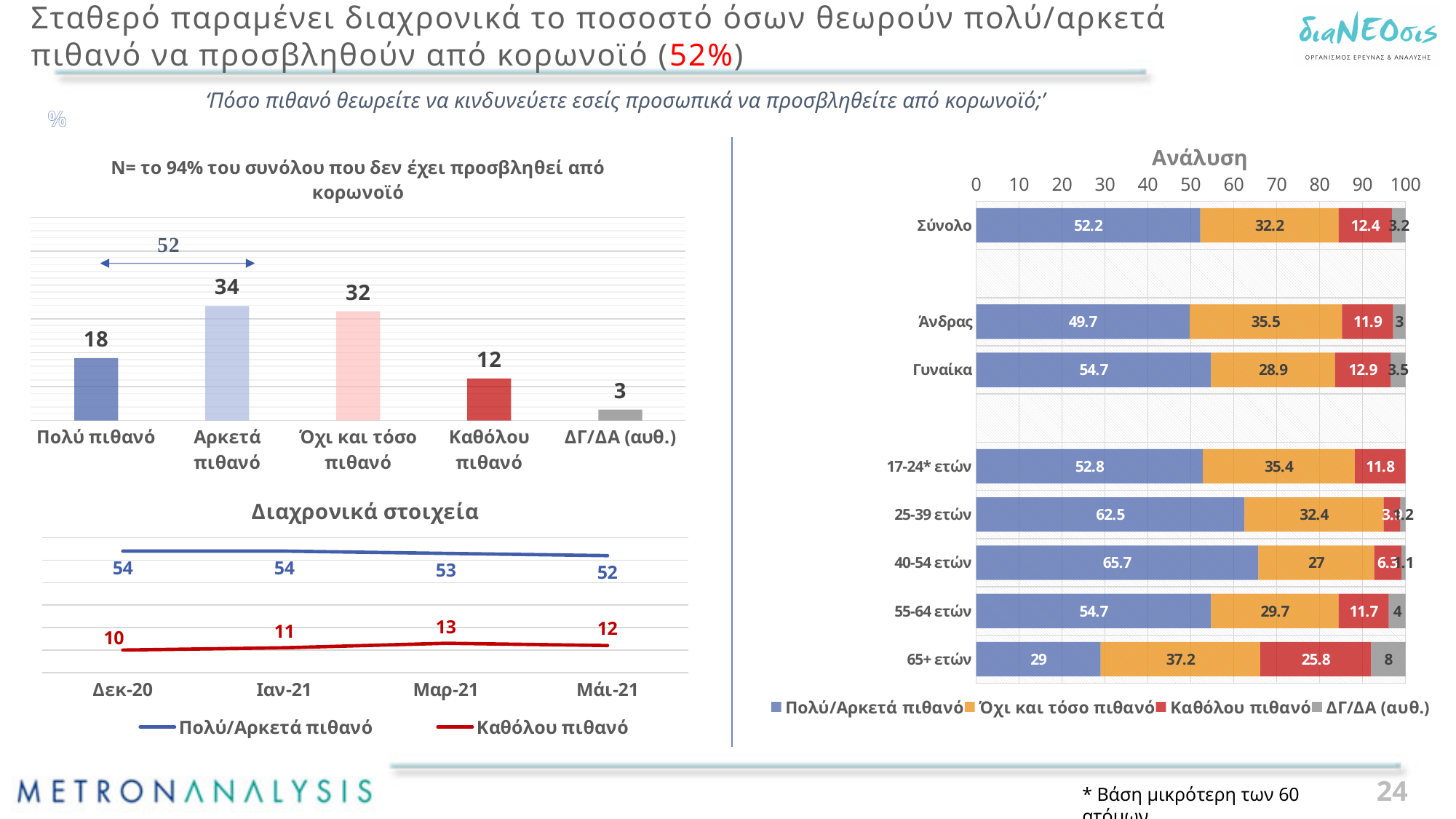
In the top-left bar chart (N= το 94% του συνόλου...), which category has the highest value? Αρκετά πιθανό In the Διαχρονικά στοιχεία chart, how many series does the legend list? 2 In the Ανάλυση chart, what is the Πολύ/Αρκετά πιθανό value for 40-54 ετών? 65.7 In the top-left bar chart (N= το 94% του συνόλου...), what is the value for Αρκετά πιθανό? 34 In the top-left bar chart (N= το 94% του συνόλου...), how many categories are shown? 5 In the top-left bar chart (N= το 94% του συνόλου...), what is the difference between Πολύ πιθανό and Καθόλου πιθανό? 6 In the Ανάλυση chart, is the Πολύ/Αρκετά πιθανό value for Γυναίκα larger or smaller than for Άνδρας? larger In the Διαχρονικά στοιχεία chart, what is the value for Καθόλου πιθανό at Μαρ-21? 13 In the Ανάλυση chart, which group has the highest Καθόλου πιθανό value? 65+ ετών In the top-left bar chart (N= το 94% του συνόλου...), which category has the lowest value? ΔΓ/ΔΑ (αυθ.) In the Διαχρονικά στοιχεία chart, does the Πολύ/Αρκετά πιθανό line rise or fall from Δεκ-20 to Μάι-21? fall What kind of chart is the Διαχρονικά στοιχεία chart? line chart